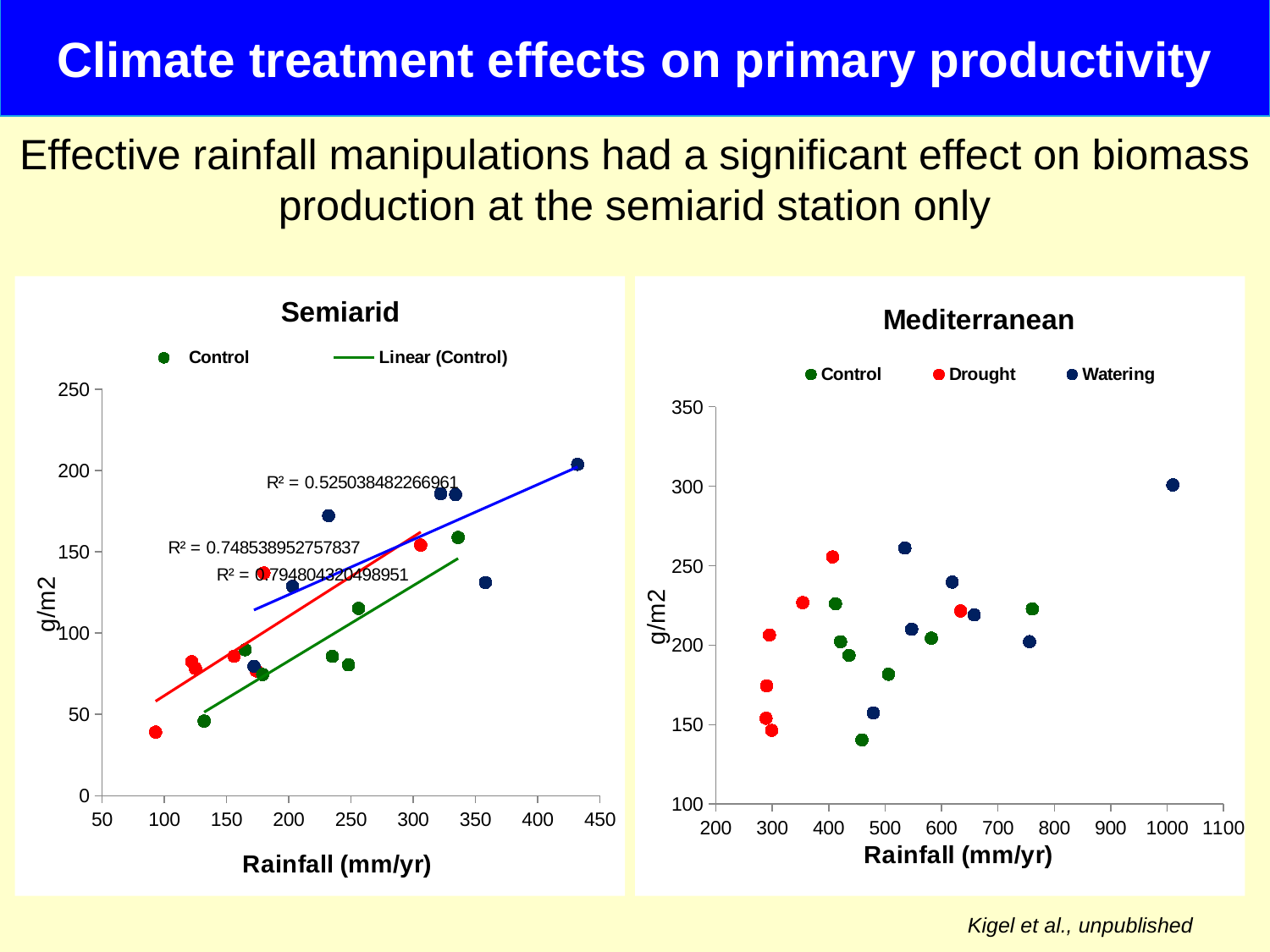
In the Mediterranean chart, which series are listed in the legend? Control, Drought, Watering In the Semiarid chart, is the g/m2 value of the leftmost point (at about 90 mm/yr rainfall) greater or less than 50? less In the Mediterranean chart, is the g/m2 value of the point at about 1000 mm/yr rainfall greater or less than 250? greater How many series does the legend of the Mediterranean chart list? 3 In the Semiarid chart, is the g/m2 value of the point at about 430 mm/yr rainfall greater or less than 150? greater In the Semiarid chart, what is the highest R² value printed on the chart? 0.794804320498951 What kind of chart is the Semiarid chart? scatter chart In the Semiarid chart, do the g/m2 values generally rise or fall as rainfall increases? rise What is the x-axis title of the Semiarid chart? Rainfall (mm/yr) In the Semiarid chart, what is the lowest R² value printed on the chart? 0.525038482266961 In the Semiarid chart, what R² value is printed for the line with the middle value of the three? 0.748538952757837 How many entries does the legend of the Semiarid chart list? 2